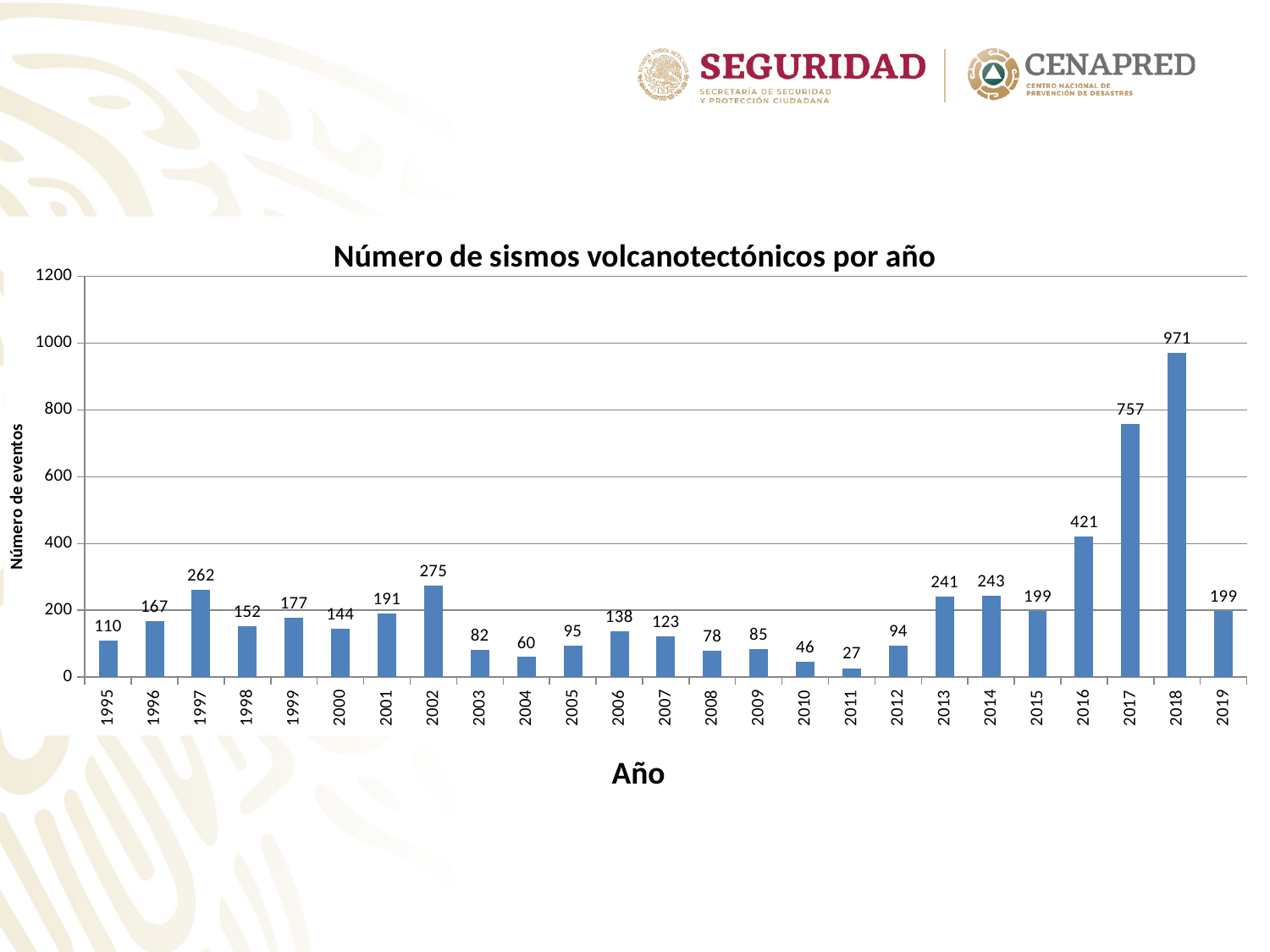
What is the number of events for 2018? 971 What kind of chart is this? bar chart Which year has a larger value, 2013 or 2014? 2014 Which year has the highest number of events? 2018 Is the value for 2016 greater or less than 400? greater How many years are shown on the x axis? 25 What is the number of events for 2002? 275 Do the values rise or fall from 2015 to 2018? rise What is the label of the y axis? Número de eventos Which year has the lowest number of events? 2011 What is the title of the chart? Número de sismos volcanotectónicos por año What is the difference between the values for 2018 and 2017? 214